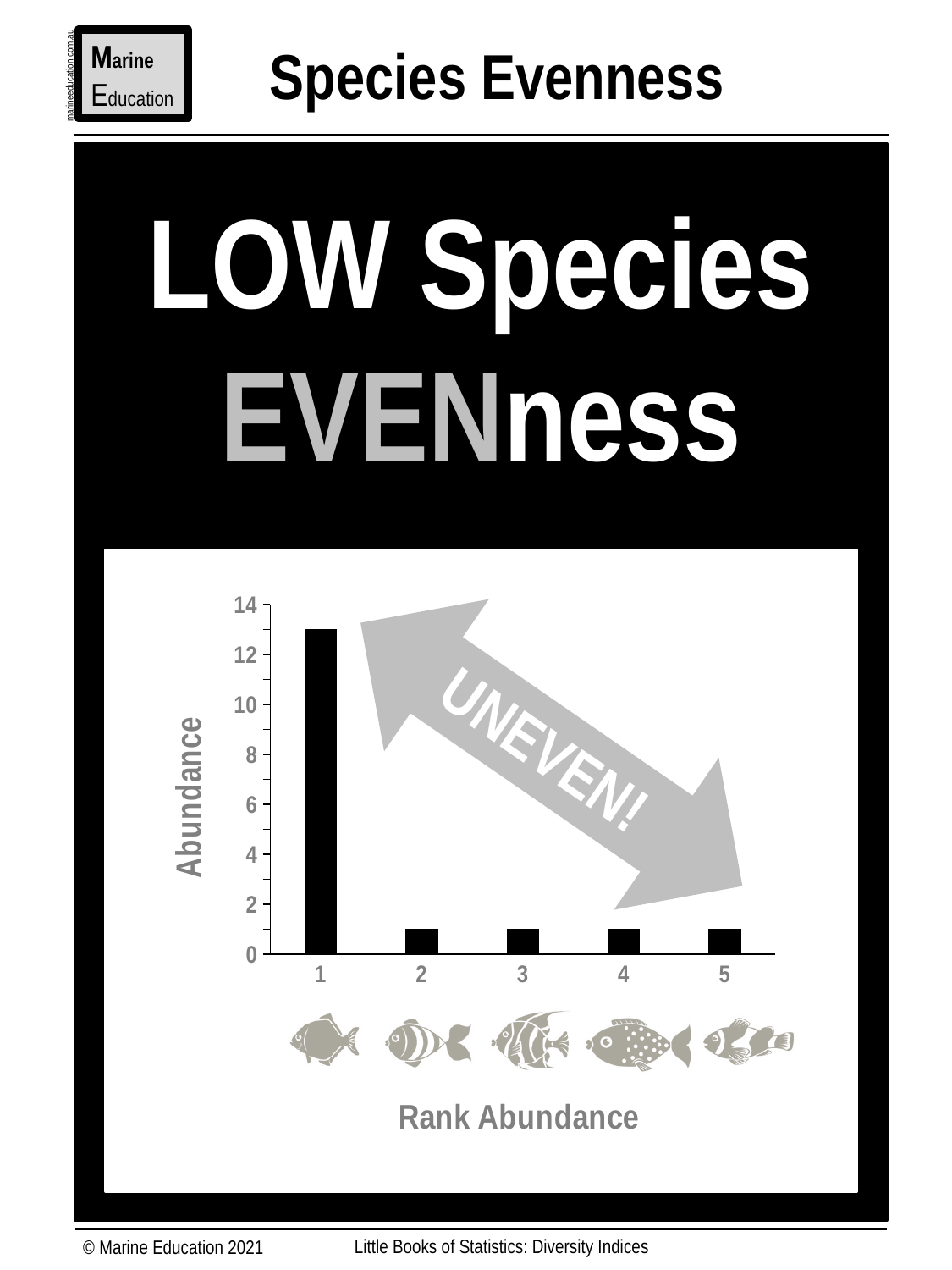
What is the title of the y axis of the chart? Abundance Is the abundance value for rank 1 greater or less than 12? greater How many rank categories are plotted on the x axis of the chart? 5 Which has the larger abundance, rank 1 or rank 3? rank 1 Do the abundance values rise or fall from rank 1 to rank 5 along the x axis? fall What is the title of the x axis of the chart? Rank Abundance Is the abundance value for rank 5 greater or less than 4? less Is the abundance value for rank 2 greater or less than 2? less What kind of chart is shown on the slide? bar chart Which rank has the highest abundance in the chart? 1